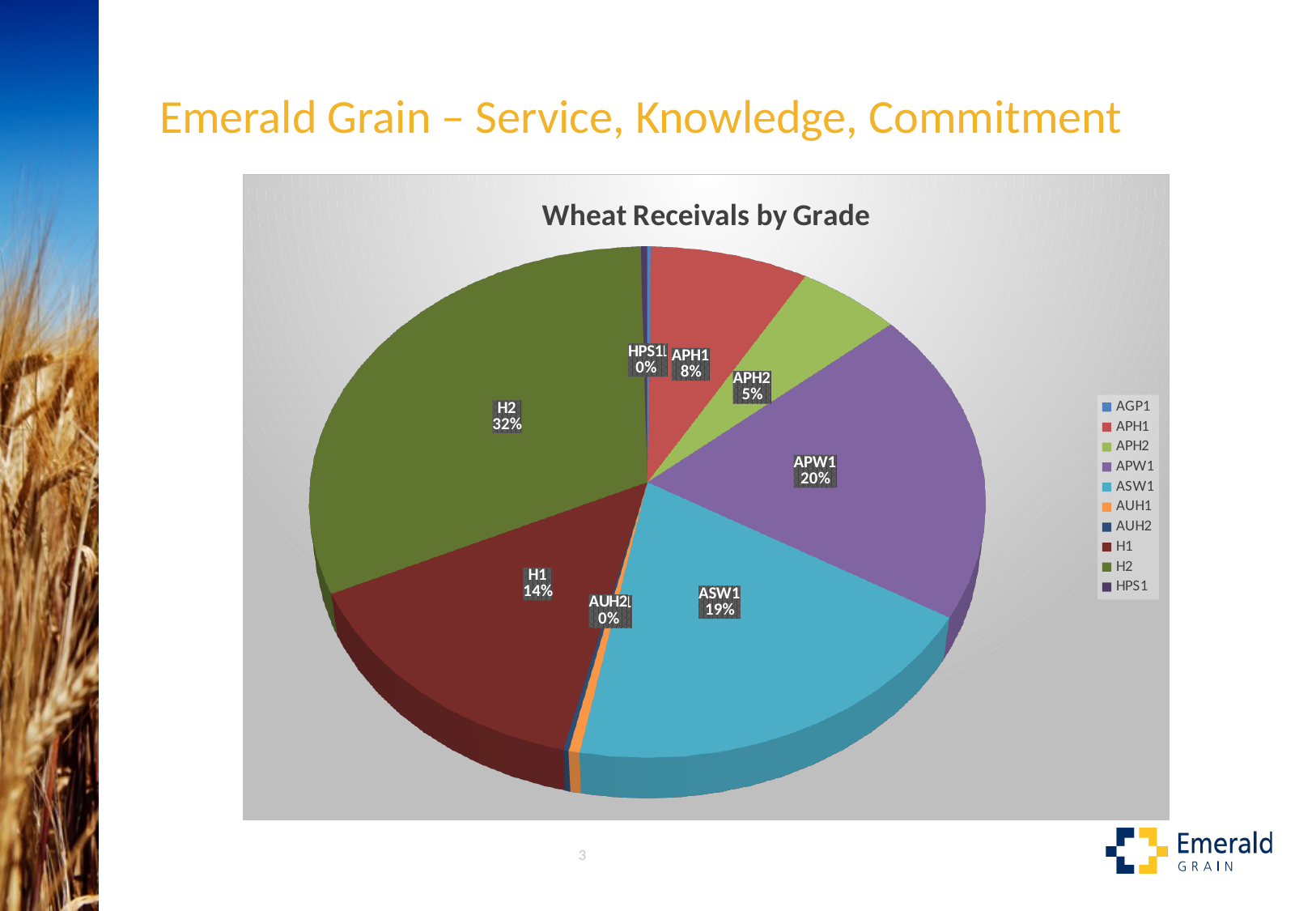
What share of wheat receivals is grade APW1? 20% How many grades are listed in the chart legend? 10 Which grade has the larger share, APH1 or H1? H1 What share of wheat receivals is grade H2? 32% What is the combined share of APW1 and ASW1? 39% What kind of chart is shown on the slide? Pie chart What share of wheat receivals is grade APH2? 5% Which grade has the largest share of wheat receivals? H2 What is the title of the chart? Wheat Receivals by Grade How many percentage points larger is the H2 share than the APW1 share? 12 percentage points What share of wheat receivals is grade ASW1? 19% What share of wheat receivals is grade H1? 14%